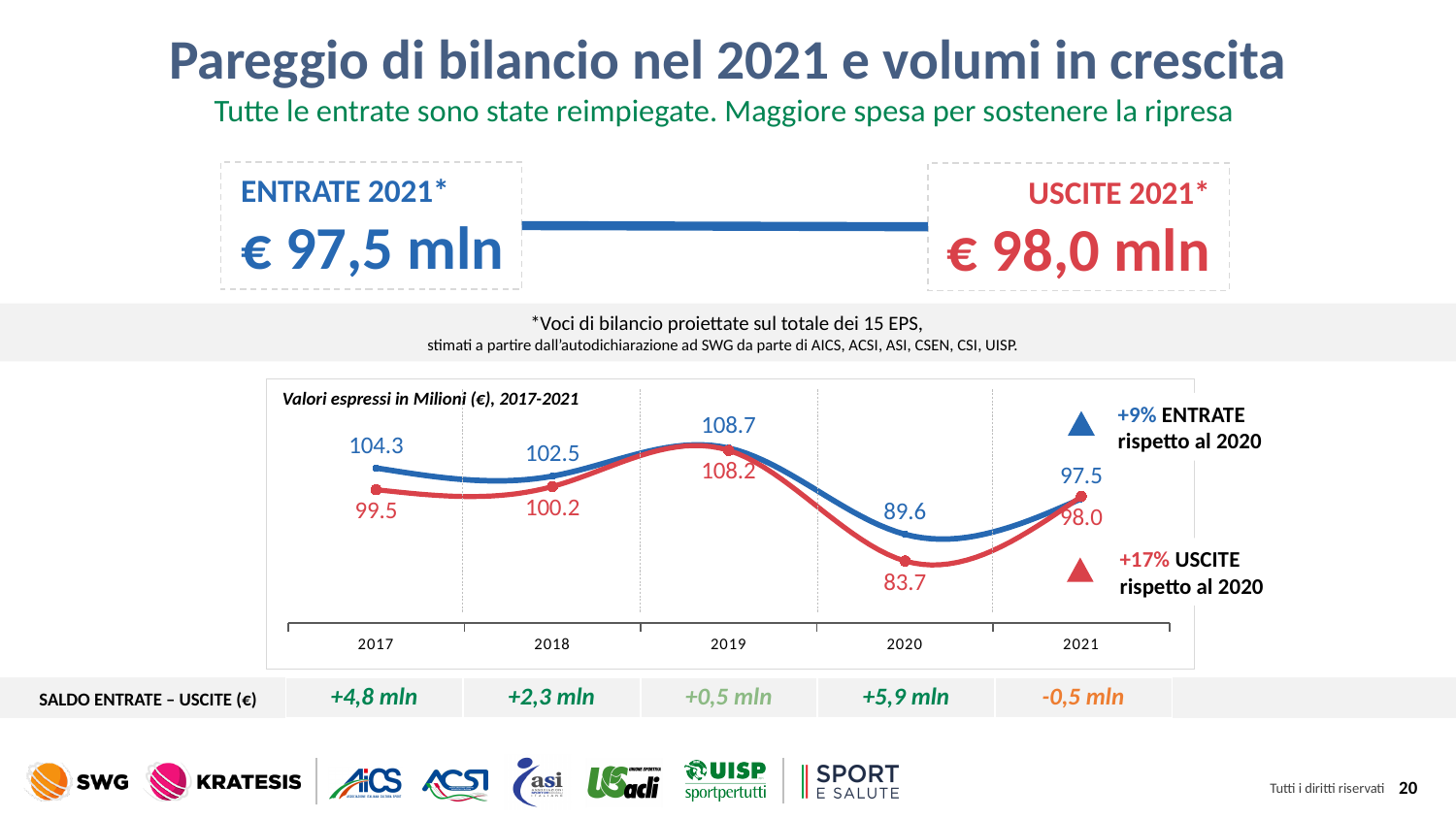
What is the value of the blue line (Entrate) in 2017? 104.3 In which year does the blue line (Entrate) reach its highest value? 2019 How does the blue line (Entrate) change from 2019 to 2020? It falls What is the difference between the blue line (Entrate) and the red line (Uscite) in 2020? 5.9 What is the value of the red line (Uscite) in 2018? 100.2 In which year does the red line (Uscite) reach its lowest value? 2020 What does the note in the top-left corner of the chart say the values are expressed in? Valori espressi in Milioni (€), 2017-2021 In 2021, which is larger: the blue line (Entrate) or the red line (Uscite)? Uscite (red line) What is the value of the red line (Uscite) in 2020? 83.7 What is the value of the blue line (Entrate) in 2019? 108.7 How many years are plotted on the x axis of the chart? 5 What type of chart is shown on the slide? line chart